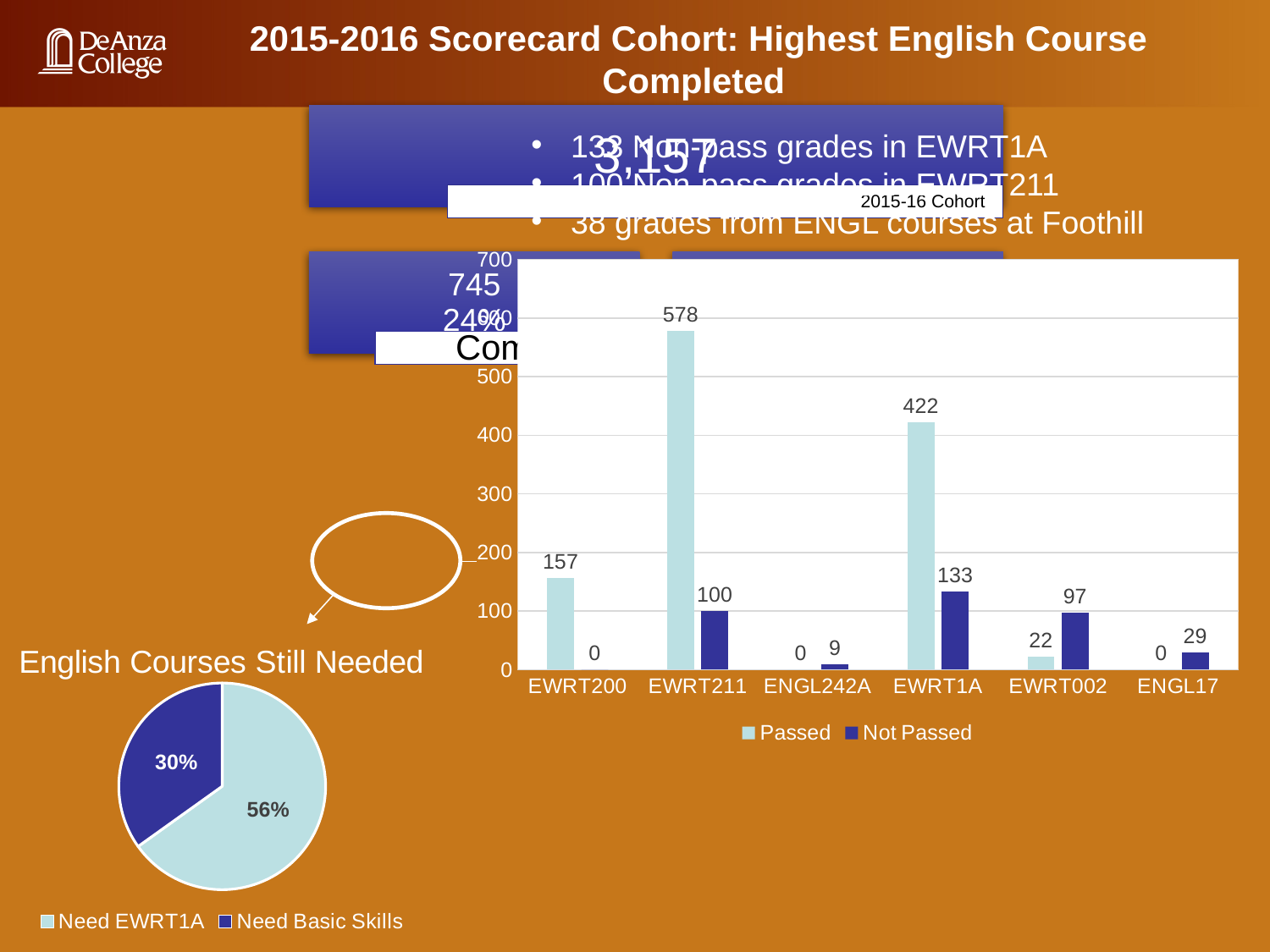
In the 'English Courses Still Needed' pie chart, which slice is larger: Need EWRT1A or Need Basic Skills? Need EWRT1A What type of chart is the 'English Courses Still Needed' chart? pie chart In the 'English Courses Still Needed' pie chart, what share is labelled Need Basic Skills? 30% How many courses are shown on the x axis of the bar chart? 6 In the bar chart, what is the Passed value for EWRT002? 22 In the bar chart, what is the Not Passed value for EWRT1A? 133 In the bar chart, which course has the highest Passed value? EWRT211 In the bar chart, what is the difference between the Passed and Not Passed values for EWRT1A? 289 How many series does the bar chart legend list? 2 In the bar chart, which course has the highest Not Passed value? EWRT1A In the bar chart, which is larger for EWRT002: Passed or Not Passed? Not Passed In the bar chart, how many students passed EWRT211? 578